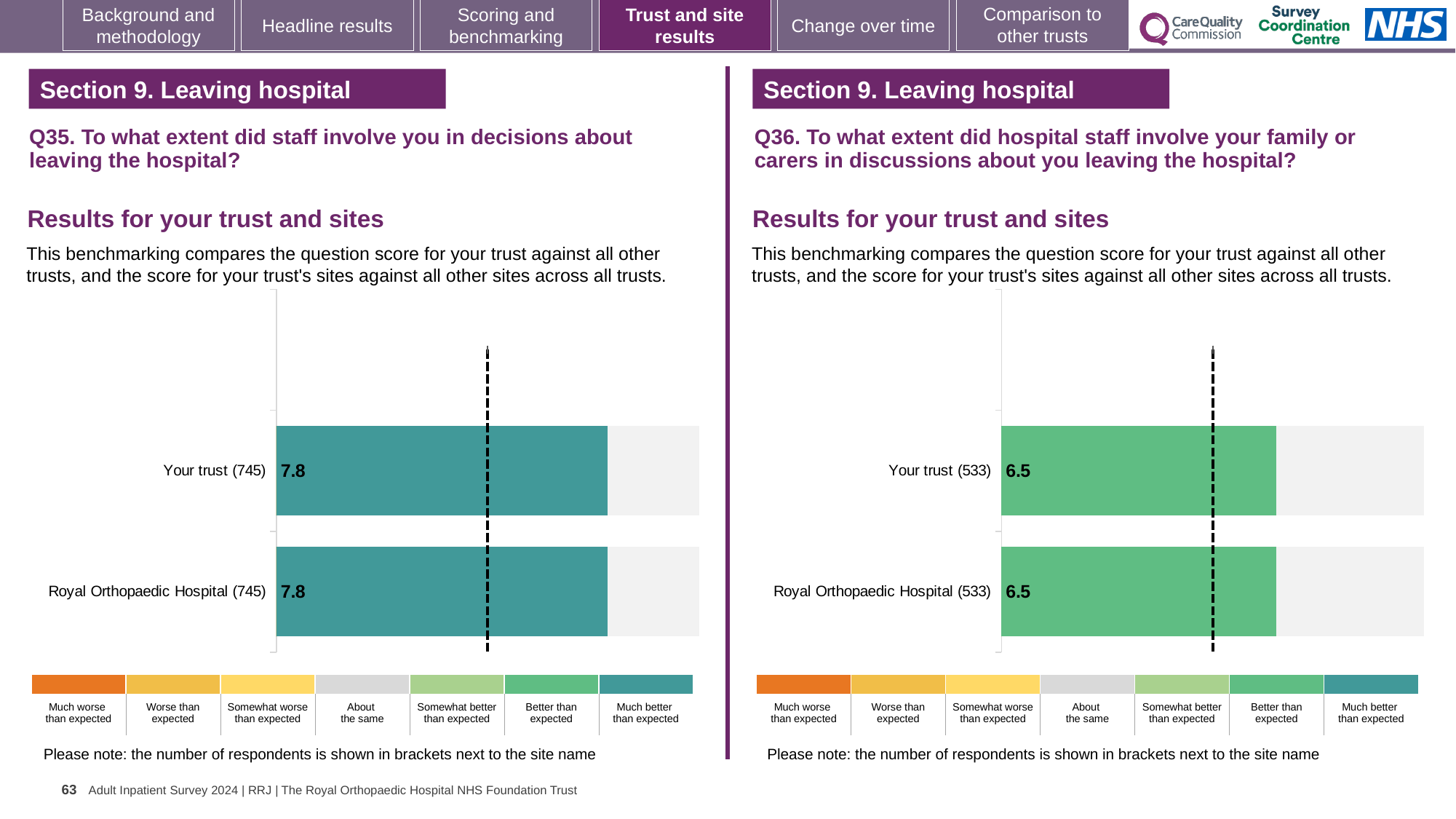
In the Q36 chart on the right, what is the difference between the Your trust score and the Royal Orthopaedic Hospital score? 0 Is the Your trust score in the Q35 chart on the left larger or smaller than the Your trust score in the Q36 chart on the right? Larger In the Q35 chart on the left, what is the difference between the Your trust score and the Royal Orthopaedic Hospital score? 0 In the Q36 chart on the right, what is the score for Your trust? 6.5 How many bars are plotted in the Q35 chart on the left? 2 In the Q36 chart on the right, how many respondents are shown in brackets next to Royal Orthopaedic Hospital? 533 In the Q36 chart on the right, what is the score for Royal Orthopaedic Hospital? 6.5 In the Q35 chart on the left, how many respondents are shown in brackets next to Your trust? 745 What type of chart is used for the Q36 results on the right? Bar chart In the Q35 chart on the left, what is the score for Royal Orthopaedic Hospital? 7.8 In the Q35 chart on the left, what is the score for Your trust? 7.8 How many bars are plotted in the Q36 chart on the right? 2